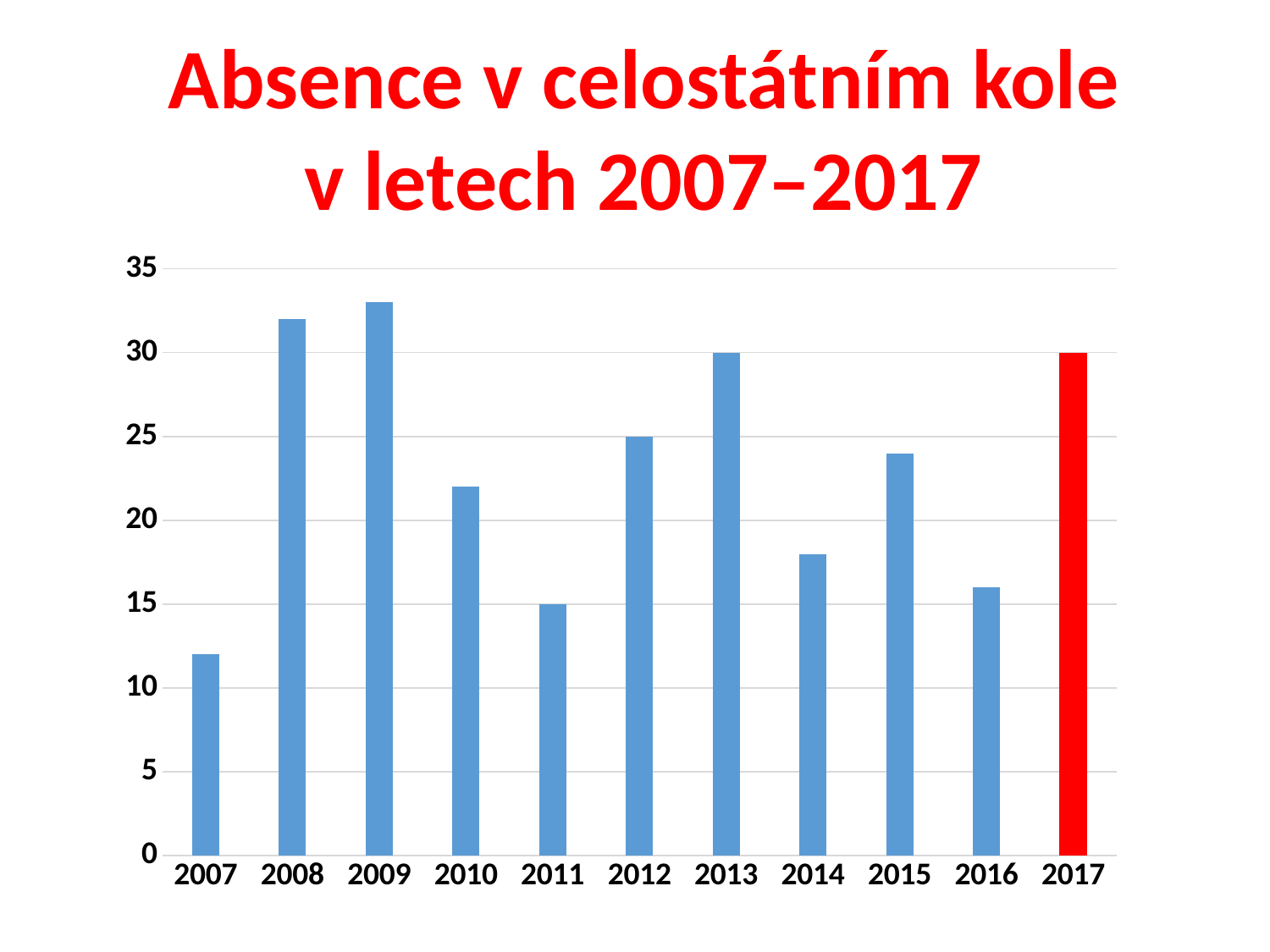
Which year has the lowest value in the chart? 2007 Is the value for 2008 greater or less than 30? greater What is the value for 2012? 25 What is the title of the slide? Absence v celostátním kole v letech 2007–2017 Is the value for 2014 greater or less than 20? less What is the value for 2011? 15 What kind of chart is shown on the slide? bar chart What is the value for 2017? 30 Which is larger, the value for 2010 or the value for 2016? 2010 How many years are shown on the x axis of the chart? 11 Which year has the highest value in the chart? 2009 Which bar in the chart is coloured red? 2017